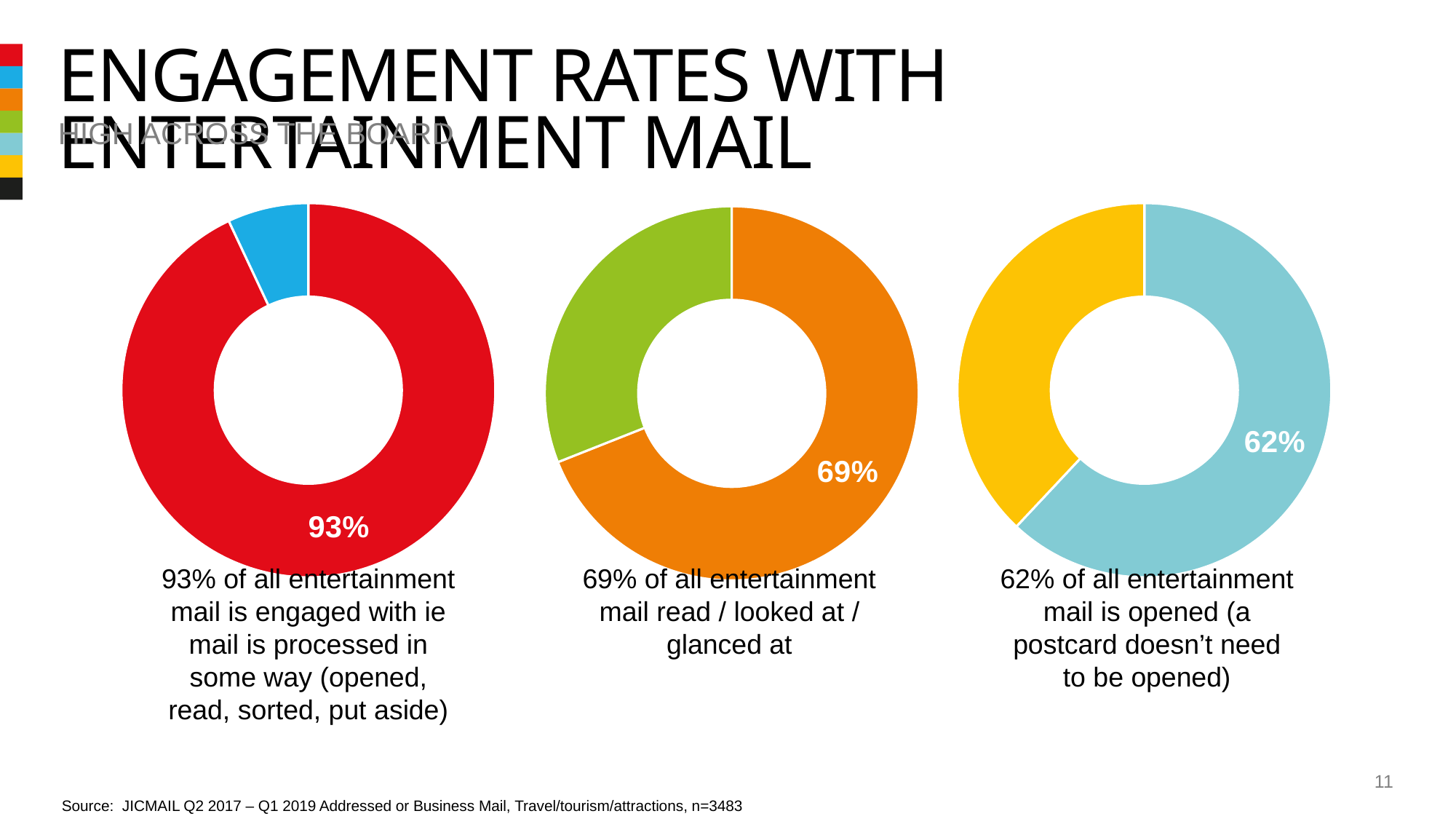
What is the difference between the percentage read / looked at (middle chart) and the percentage opened (right chart)? 7 percentage points In the left-hand chart, what percentage of entertainment mail is engaged with? 93% How many doughnut charts are shown on the slide? 3 In the right-hand chart, what percentage of entertainment mail is opened? 62% In the middle chart, which slice is larger, the orange one or the green one? The orange one Which of the three charts shows the lowest labelled percentage? The right-hand chart (62%) Which of the three charts shows the highest labelled percentage? The left-hand chart (93%) What colour is the 93% slice in the left-hand chart? Red What is the difference between the percentage engaged with (left chart) and the percentage read / looked at (middle chart)? 24 percentage points Which is larger: the percentage of entertainment mail engaged with (left chart) or the percentage opened (right chart)? Engaged with (93%) What kind of chart is the left-hand chart on the slide? doughnut (pie) chart In the middle chart, what percentage of entertainment mail is read / looked at / glanced at? 69%